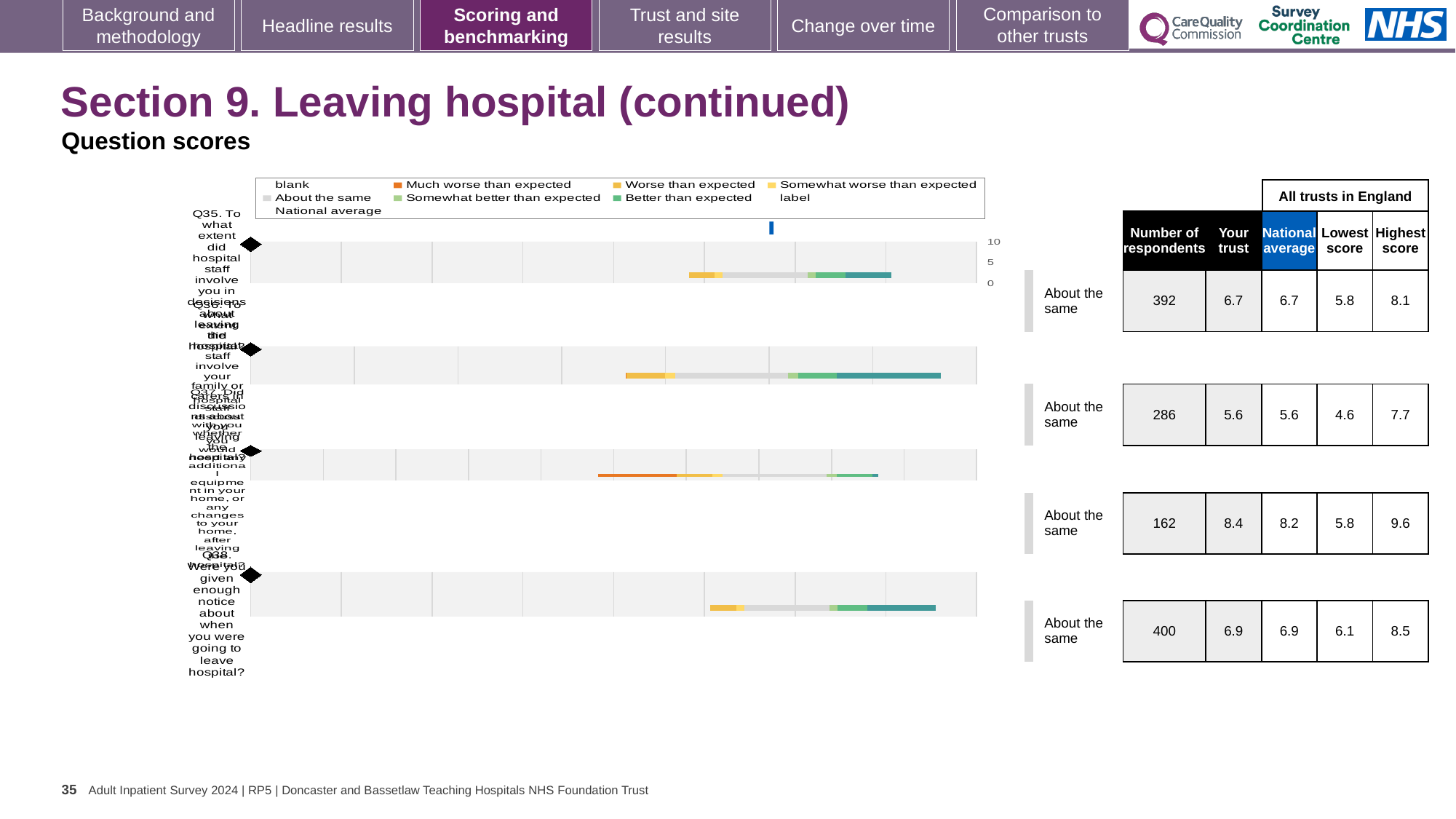
How many respondents are listed for Q37, the third question row? 162 Which question has the highest 'Your trust' score? Q37 What is the lowest score across all trusts in England for Q36, the second question row? 4.6 What benchmark category is shown for Q38? About the same What kind of chart is used to show the question scores on this slide? bar chart For Q37, what is the difference between the highest score and the lowest score across all trusts in England? 3.8 How many questions (rows) are plotted in the chart? 4 For Q37, how much higher is the 'Your trust' score than the national average? 0.2 What is the 'Your trust' score for Q38 (Were you given enough notice about when you were going to leave hospital?)? 6.9 Which question has the lowest 'Your trust' score? Q36 Which is larger: the highest score for Q38 or the highest score for Q35? Q38 (8.5) What is the national average for Q35, the first question row? 6.7